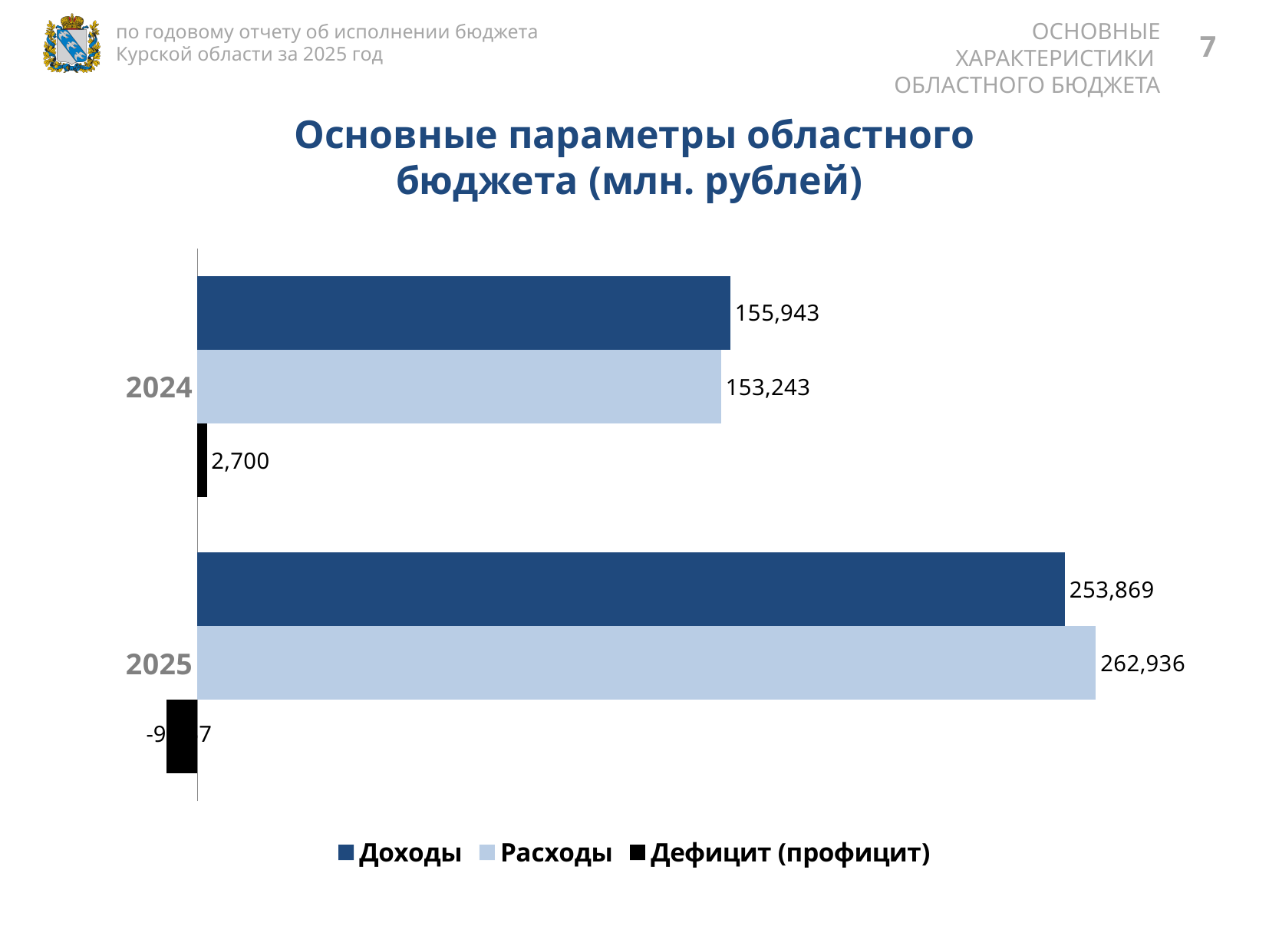
What is the difference between Доходы and Расходы in 2024? 2,700 What is the value of Доходы for 2024? 155,943 What is the value of Расходы for 2025? 262,936 Which year has the higher value of Расходы? 2025 In 2025, which is larger: Доходы or Расходы? Расходы How many years (categories) are shown on the chart? 2 What type of chart is shown on the slide? Bar chart What is the value of Расходы for 2024? 153,243 What is the difference between Расходы and Доходы in 2025? 9,067 What is the value of Дефицит (профицит) for 2024? 2,700 What is the value of Доходы for 2025? 253,869 How many series does the legend list? 3